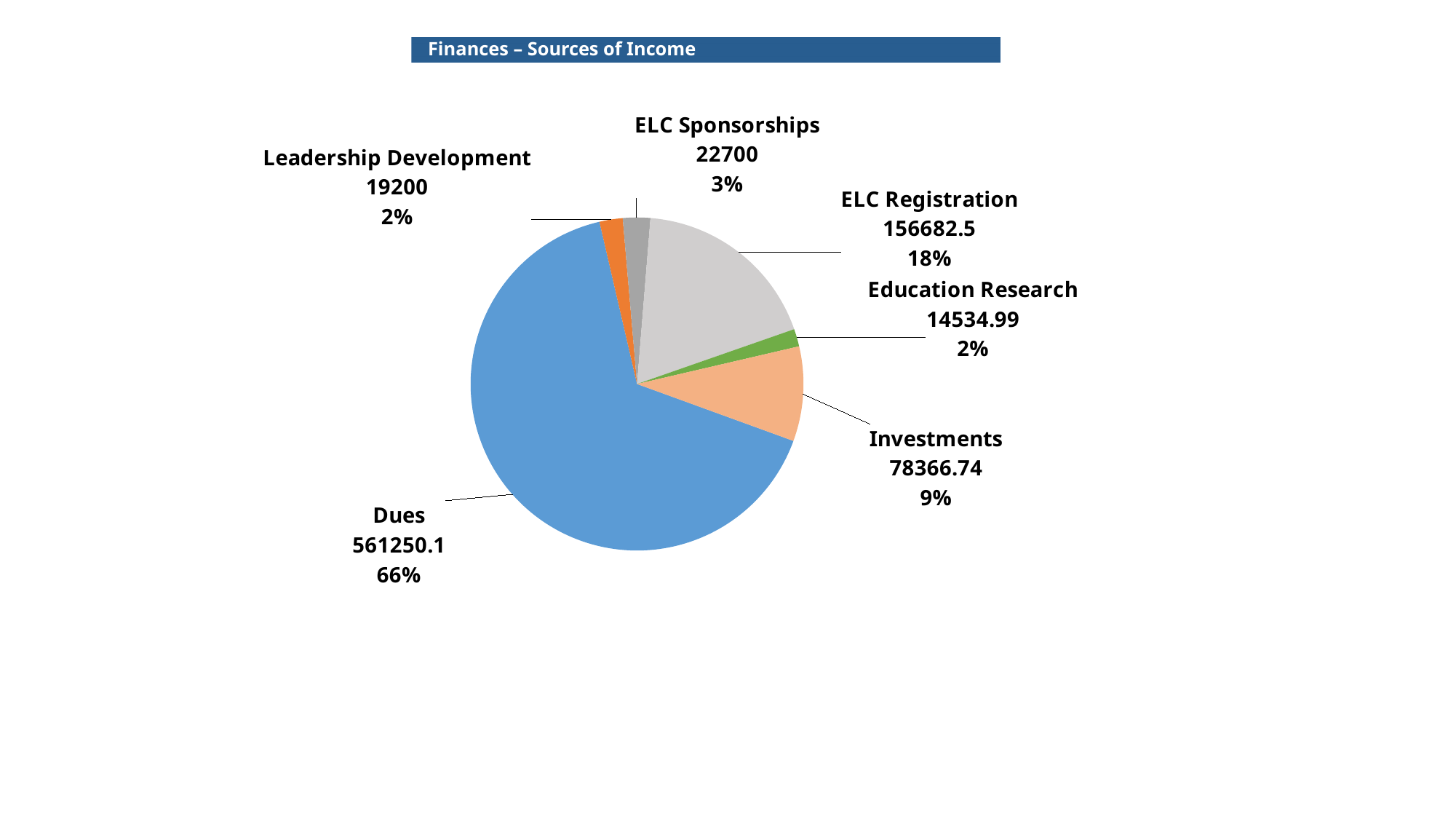
What type of chart is shown on the slide? pie chart Which category has the largest slice? Dues What is the value for ELC Sponsorships? 22700 What is the difference between the values for ELC Sponsorships and Leadership Development? 3500 What is the value for ELC Registration? 156682.5 How many categories are shown in the pie chart? 6 Which is larger, ELC Registration or Investments? ELC Registration What is the value for Investments? 78366.74 What is the value for Dues? 561250.1 What share of the pie does Investments represent? 9% What share of the pie does Dues represent? 66% Which category has the smallest value? Education Research